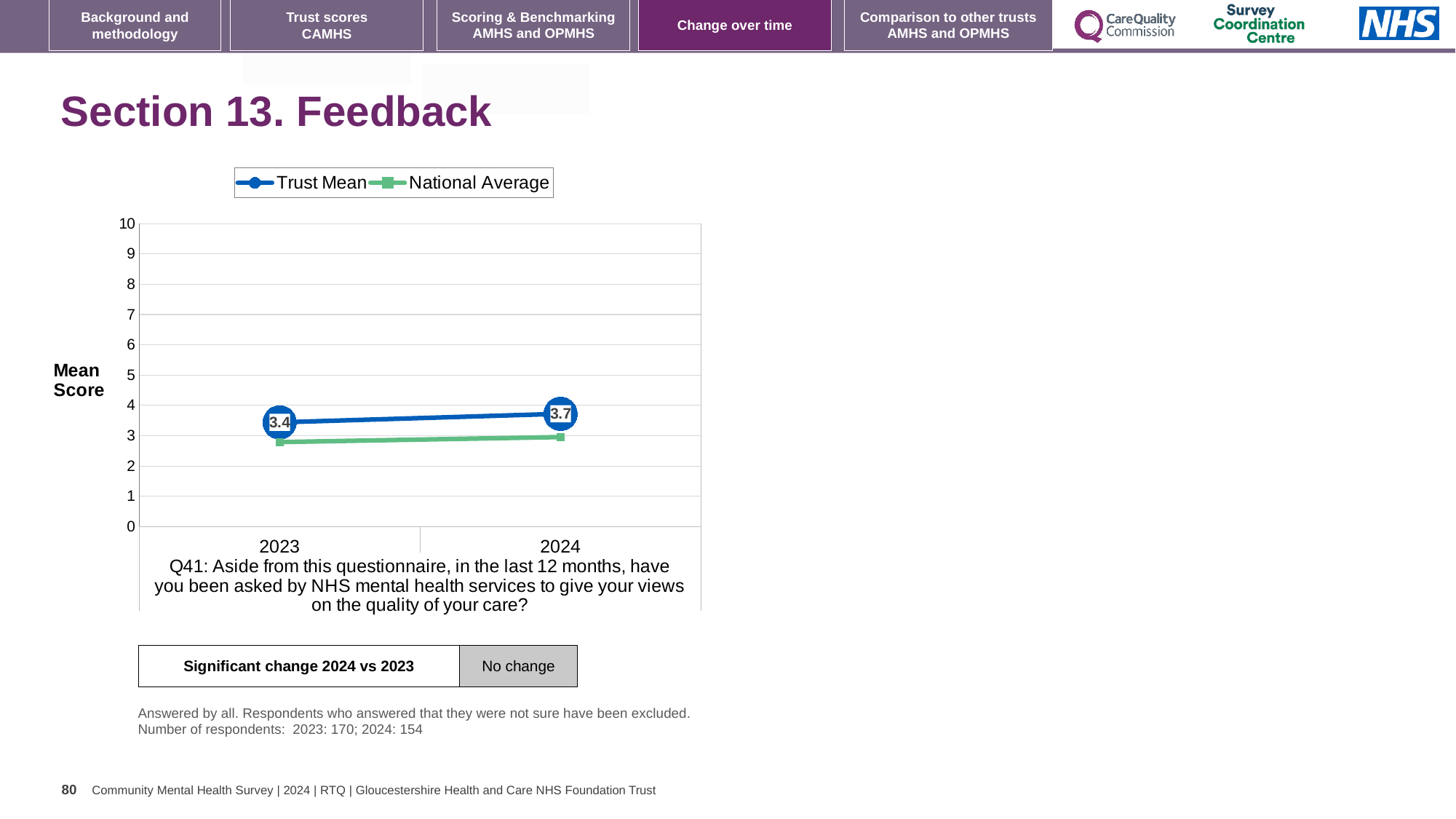
What is the Trust Mean score for 2023? 3.4 Is the National Average value for 2024 greater or less than 2? greater Does the Trust Mean rise or fall from 2023 to 2024? Rise In which year is the Trust Mean score lower? 2023 In which year is the Trust Mean score higher? 2024 In 2023, which is higher: the Trust Mean or the National Average? Trust Mean Is the National Average value for 2023 greater or less than 3? less What kind of chart is shown on the slide? Line chart By how much did the Trust Mean score change from 2023 to 2024? 0.3 How many years are shown on the x axis of the chart? 2 What is the Trust Mean score for 2024? 3.7 How many series does the chart legend list? 2